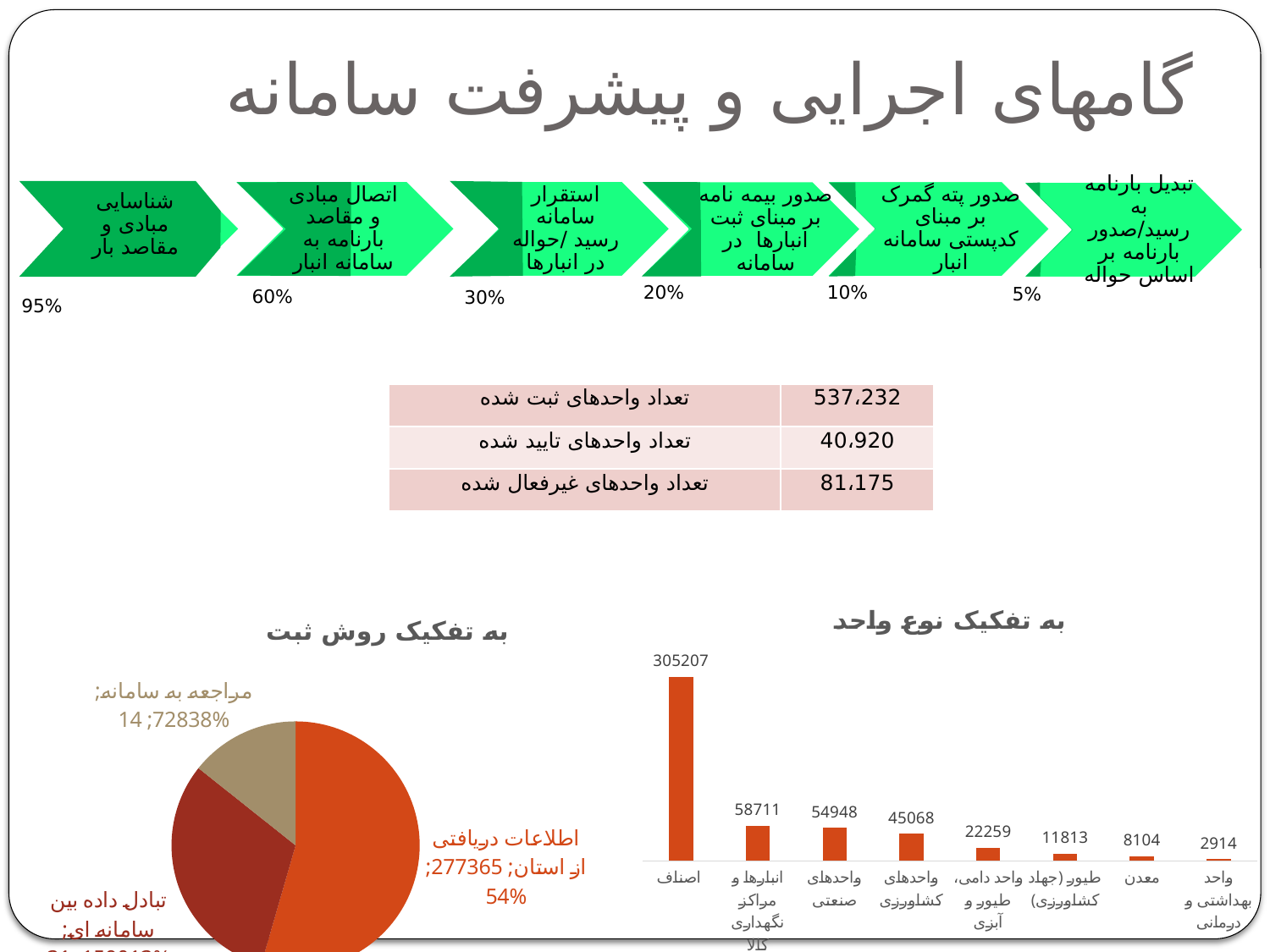
In the bar chart titled به تفکیک نوع واحد, what is the difference between the values for واحدهای صنعتی and واحدهای کشاورزی? 9880 In the bar chart titled به تفکیک نوع واحد, what is the value for واحدهای صنعتی? 54948 How many categories are shown in the bar chart titled به تفکیک نوع واحد? 8 In the bar chart titled به تفکیک نوع واحد, which is larger: the value for انبارها و مراکز نگهداری کالا or the value for واحدهای صنعتی? انبارها و مراکز نگهداری کالا What kind of chart is the chart titled به تفکیک نوع واحد? bar chart In the bar chart titled به تفکیک نوع واحد, which category has the lowest value? واحد بهداشتی و درمانی In the bar chart titled به تفکیک نوع واحد, what is the value for اصناف? 305207 In the bar chart titled به تفکیک نوع واحد, what is the value for معدن? 8104 In the bar chart titled به تفکیک نوع واحد, which category has the highest value? اصناف What kind of chart is the chart titled به تفکیک روش ثبت? pie chart In the pie chart titled به تفکیک روش ثبت, what is the value for مراجعه به سامانه? 72838 In the pie chart titled به تفکیک روش ثبت, what share does اطلاعات دریافتی از استان have? 54%